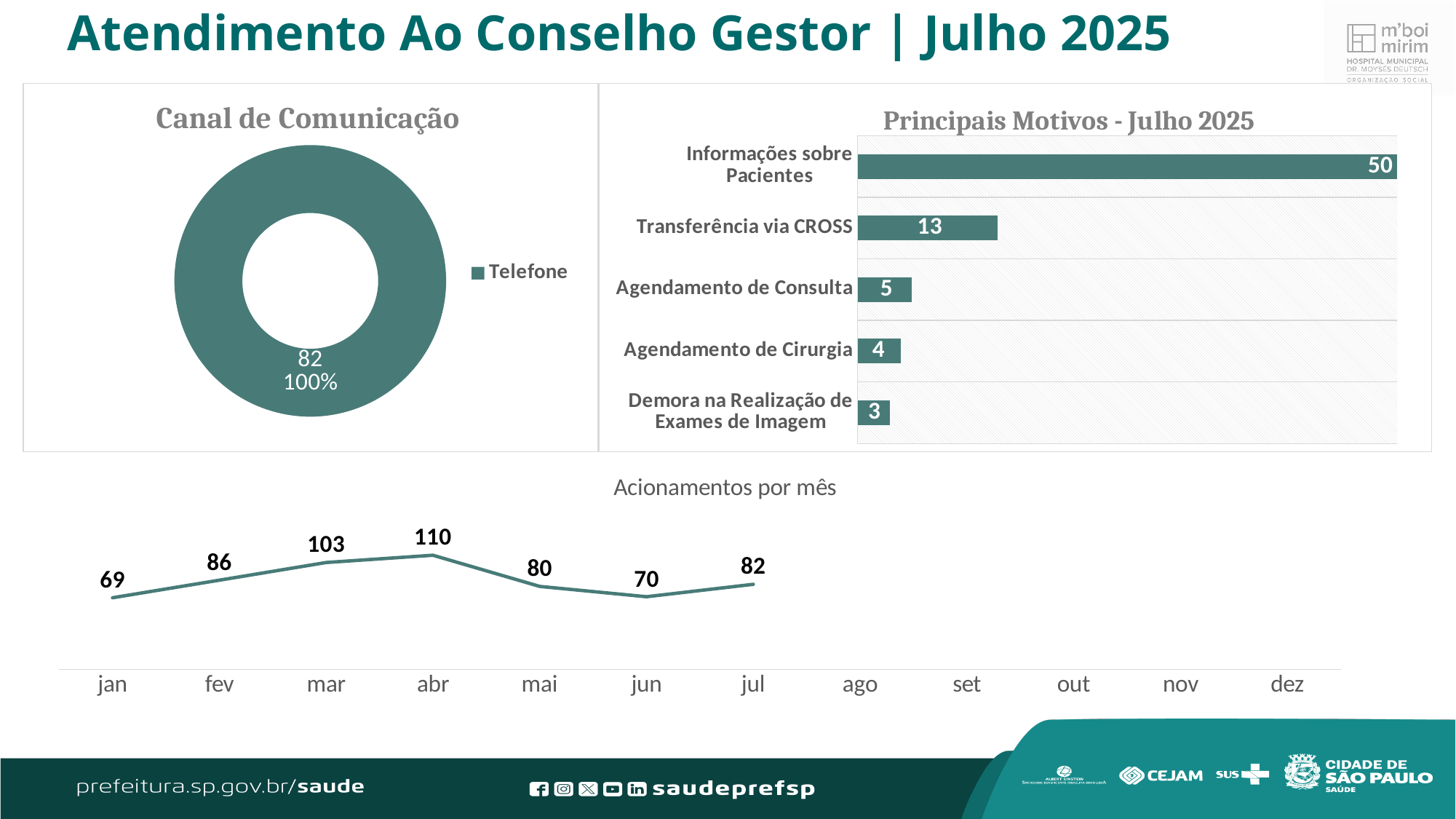
In the 'Principais Motivos - Julho 2025' chart, what is the difference between Informações sobre Pacientes and Transferência via CROSS? 37 In the 'Acionamentos por mês' chart, is the value for mar larger or the value for mai? mar In the 'Principais Motivos - Julho 2025' chart, how many categories are shown? 5 In the 'Principais Motivos - Julho 2025' chart, which category has the lowest value? Demora na Realização de Exames de Imagem What kind of chart is 'Principais Motivos - Julho 2025'? Bar chart What kind of chart is 'Canal de Comunicação'? Doughnut chart In the 'Principais Motivos - Julho 2025' chart, what is the value for Transferência via CROSS? 13 In the 'Canal de Comunicação' chart, what value is shown for Telefone? 82 In the 'Canal de Comunicação' chart, what share does Telefone represent? 100% In the 'Acionamentos por mês' chart, what is the value for abr? 110 In the 'Acionamentos por mês' chart, which month has the lowest value? jan In the 'Principais Motivos - Julho 2025' chart, which category has the highest value? Informações sobre Pacientes